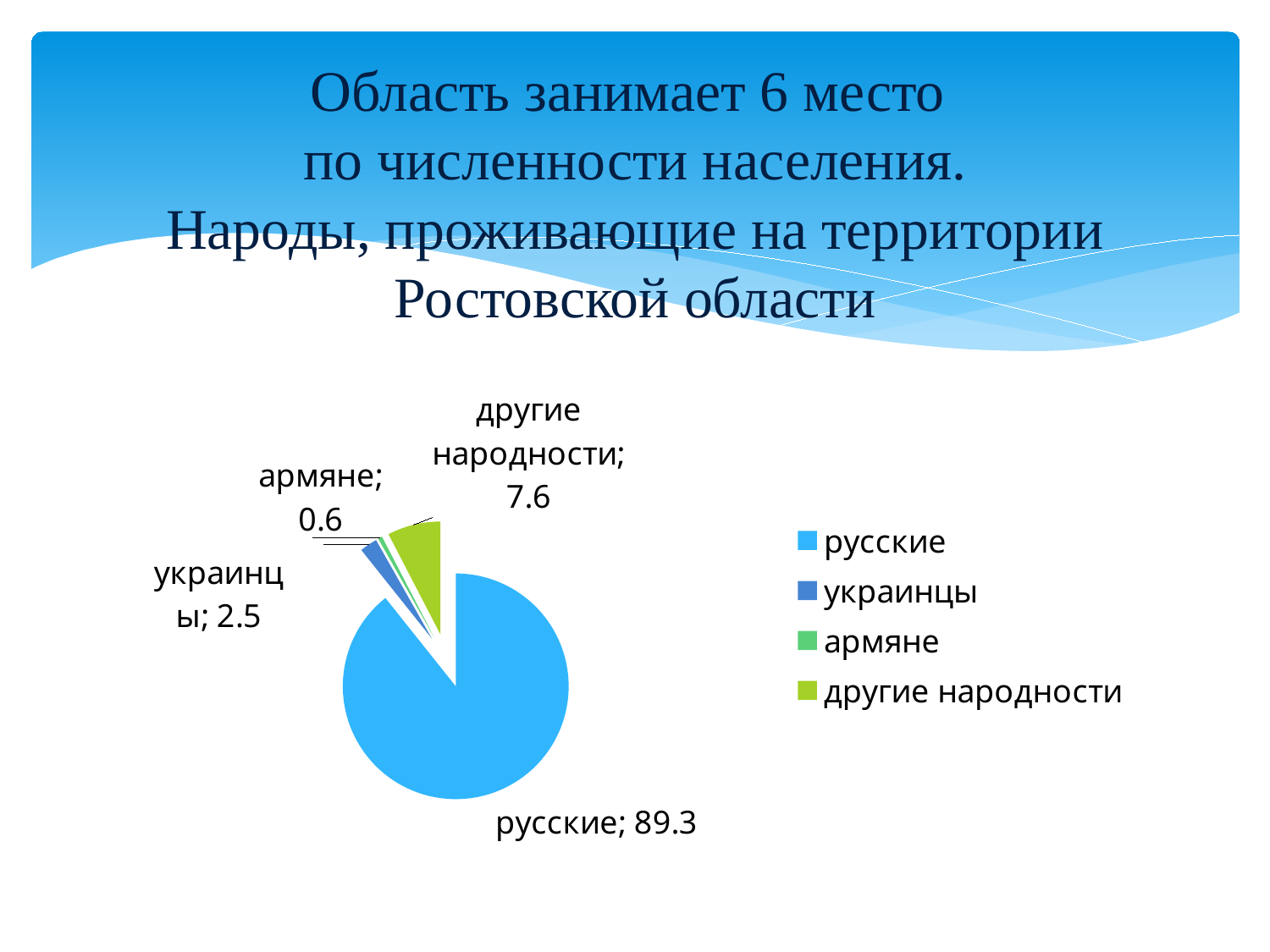
How many categories are shown in the pie chart? 4 What value is shown for русские in the pie chart? 89.3 Which category has the largest slice in the pie chart? русские What is the difference between the values for русские and другие народности? 81.7 What is the difference between the values for украинцы and армяне? 1.9 What value is shown for украинцы in the pie chart? 2.5 What value is shown for другие народности in the pie chart? 7.6 Which category has the smallest slice in the pie chart? армяне What colour is the slice for другие народности? green Which is larger, the value for украинцы or the value for другие народности? другие народности What kind of chart is shown on the slide? pie chart What value is shown for армяне in the pie chart? 0.6